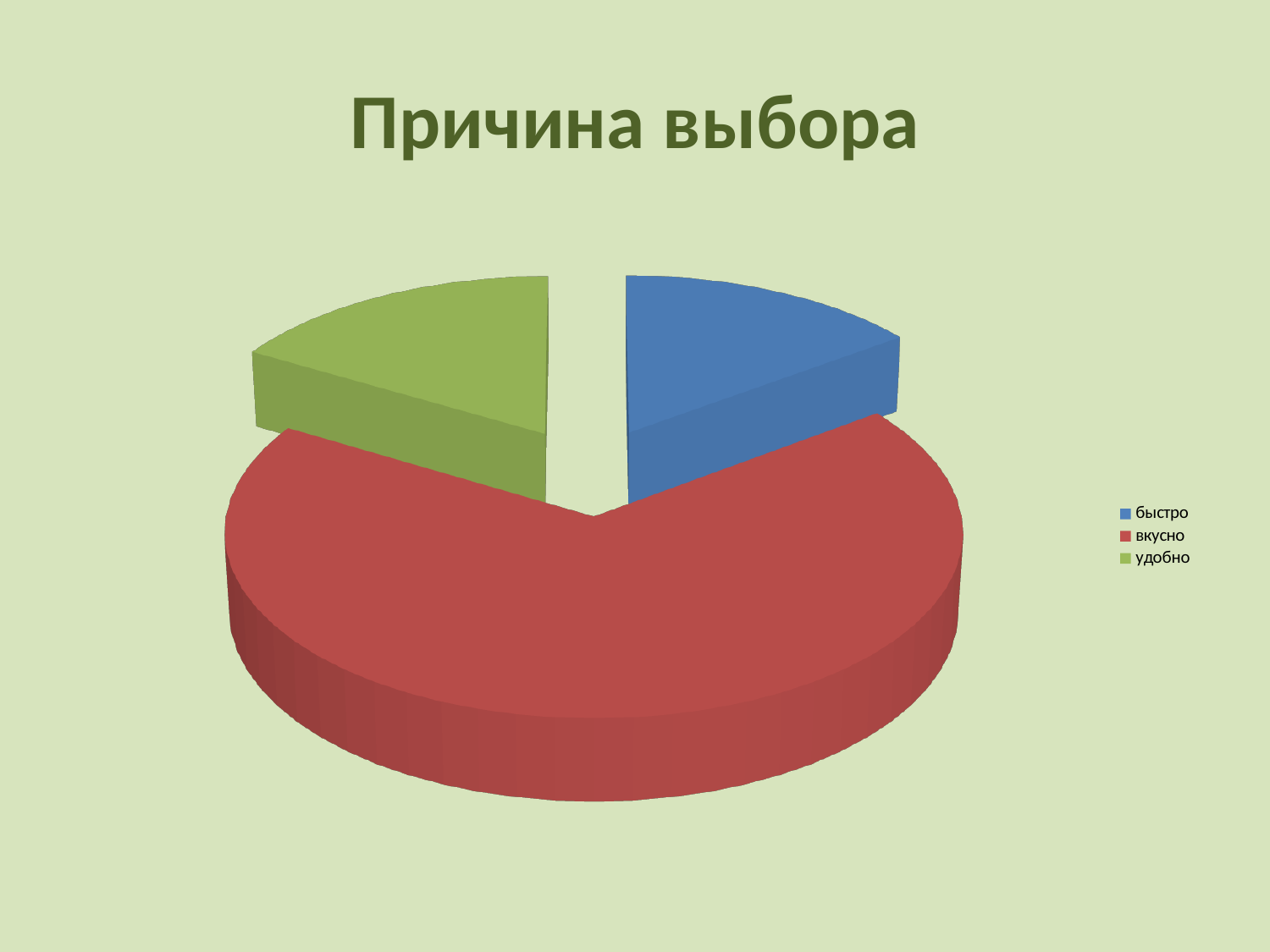
Which of the two is larger: the slice for удобно or the slice for вкусно? вкусно Which category has the largest slice of the pie? вкусно What colour is the slice for вкусно? red What kind of chart is shown on the slide? pie chart Which of the two is larger: the slice for вкусно or the slice for быстро? вкусно What is the title of the chart? Причина выбора How many categories does the pie chart have? 3 How many entries does the legend list? 3